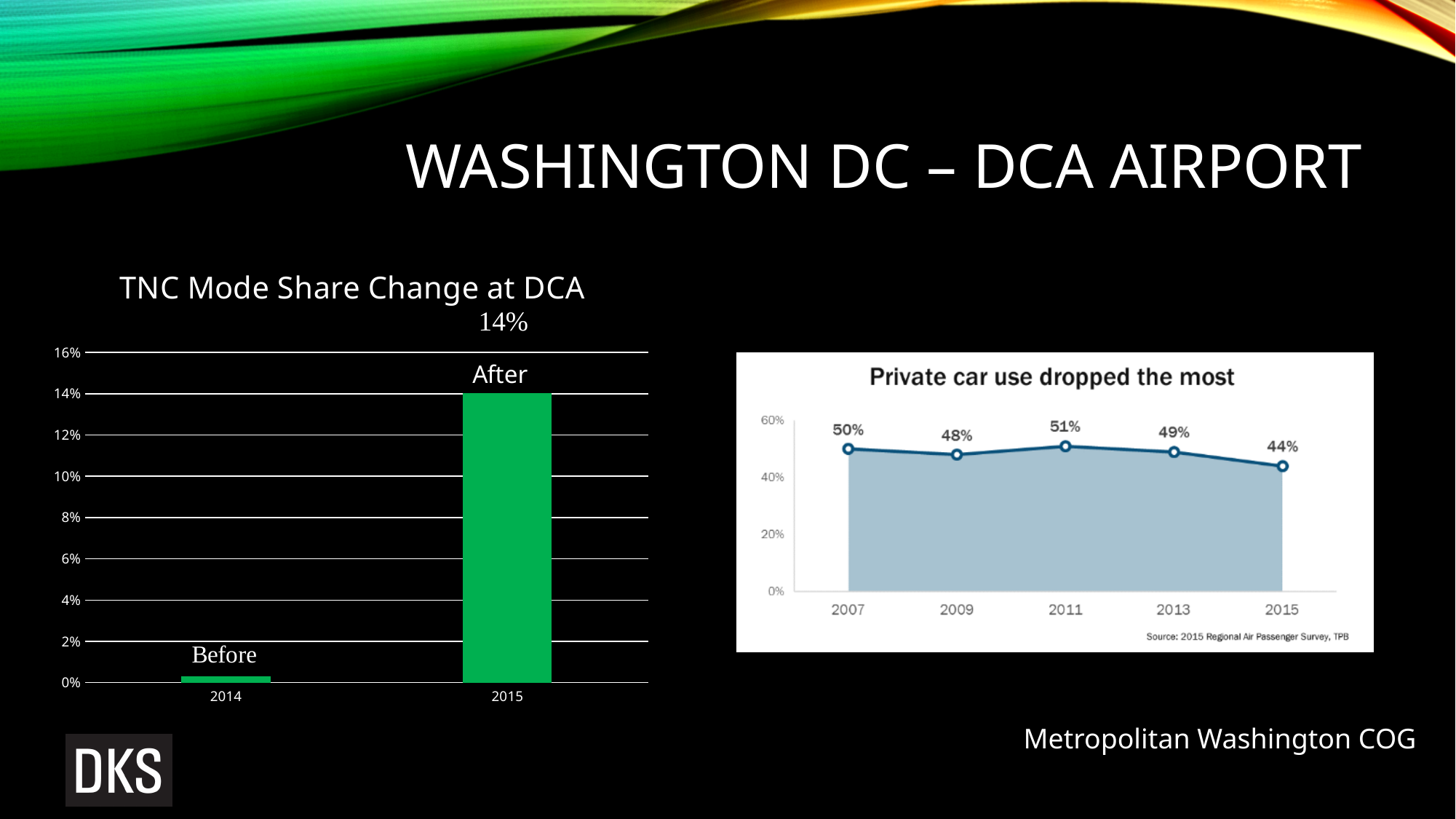
What kind of chart is 'TNC Mode Share Change at DCA'? bar chart In the 'Private car use dropped the most' chart, which year has the lowest value? 2015 How many data points are plotted in the 'Private car use dropped the most' chart? 5 In the 'TNC Mode Share Change at DCA' chart, what label is placed above the 2014 bar? Before In the 'Private car use dropped the most' chart, what is the value for 2015? 44% In the 'Private car use dropped the most' chart, what is the difference between the 2007 value and the 2015 value? 6% How many bars are shown in the 'TNC Mode Share Change at DCA' chart? 2 In the 'TNC Mode Share Change at DCA' chart, what is the value for 2015? 14% In the 'TNC Mode Share Change at DCA' chart, is the value for 2014 greater or less than 2%? less In the 'Private car use dropped the most' chart, what is the value for 2011? 51% In the 'Private car use dropped the most' chart, which year has the highest value? 2011 In the 'TNC Mode Share Change at DCA' chart, which year has the higher value, 2014 or 2015? 2015